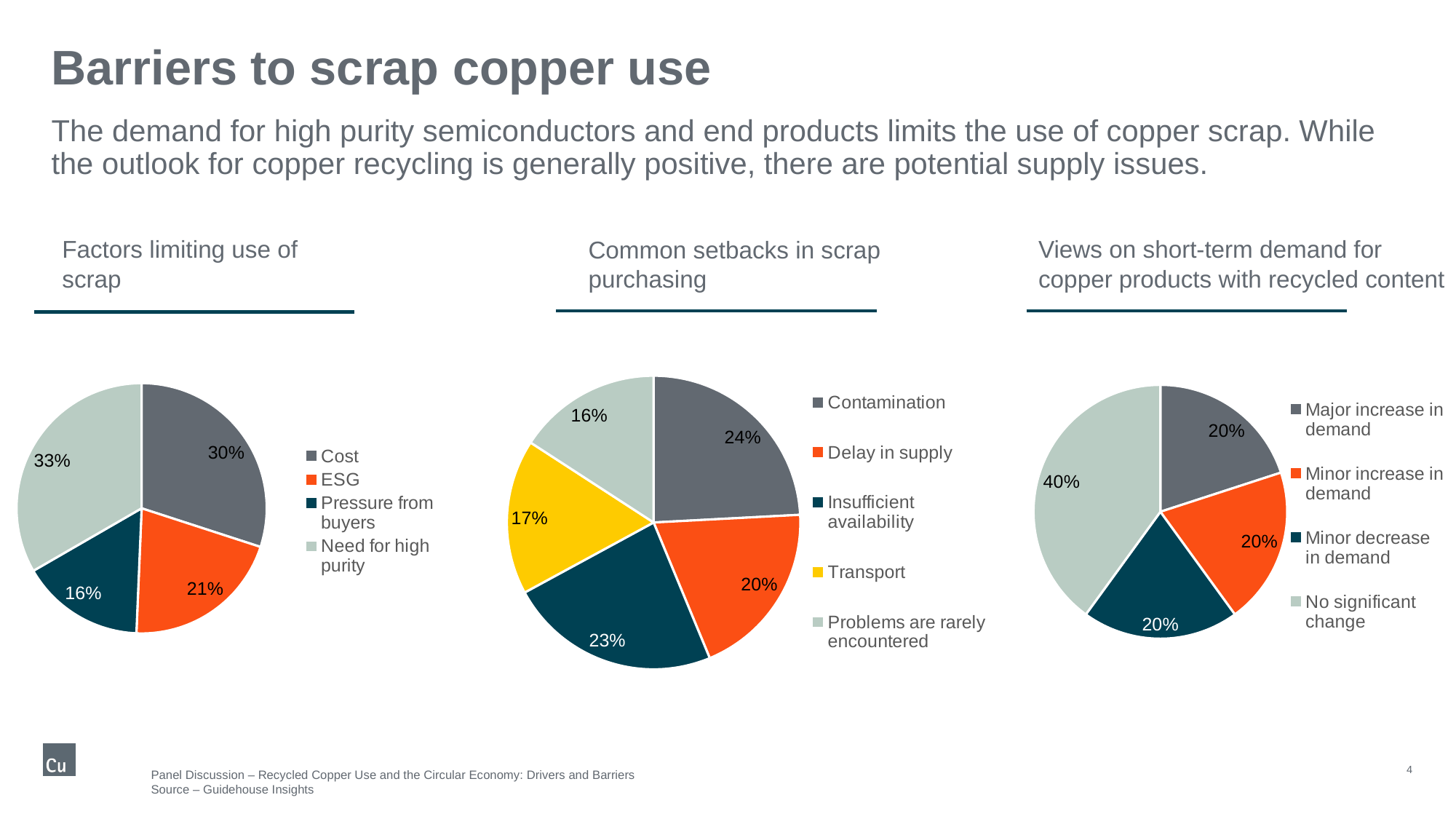
What type of chart is used for 'Factors limiting use of scrap'? Pie chart In the 'Factors limiting use of scrap' chart, what share is labelled for Cost? 30% In the 'Common setbacks in scrap purchasing' chart, what share is labelled for Transport? 17% In the 'Common setbacks in scrap purchasing' chart, which setback has the largest share? Contamination In the 'Views on short-term demand for copper products with recycled content' chart, what share is labelled for No significant change? 40% In the 'Factors limiting use of scrap' chart, which factor has the smallest share? Pressure from buyers In the 'Views on short-term demand for copper products with recycled content' chart, what is the difference in percentage points between No significant change and Major increase in demand? 20 In the 'Factors limiting use of scrap' chart, what is the difference in percentage points between Need for high purity and ESG? 12 In the 'Common setbacks in scrap purchasing' chart, what colour is the Transport slice? Yellow In the 'Common setbacks in scrap purchasing' chart, which is larger: Insufficient availability or Delay in supply? Insufficient availability In the 'Factors limiting use of scrap' chart, which factor has the largest share? Need for high purity In the 'Common setbacks in scrap purchasing' chart, how many categories does the legend list? 5